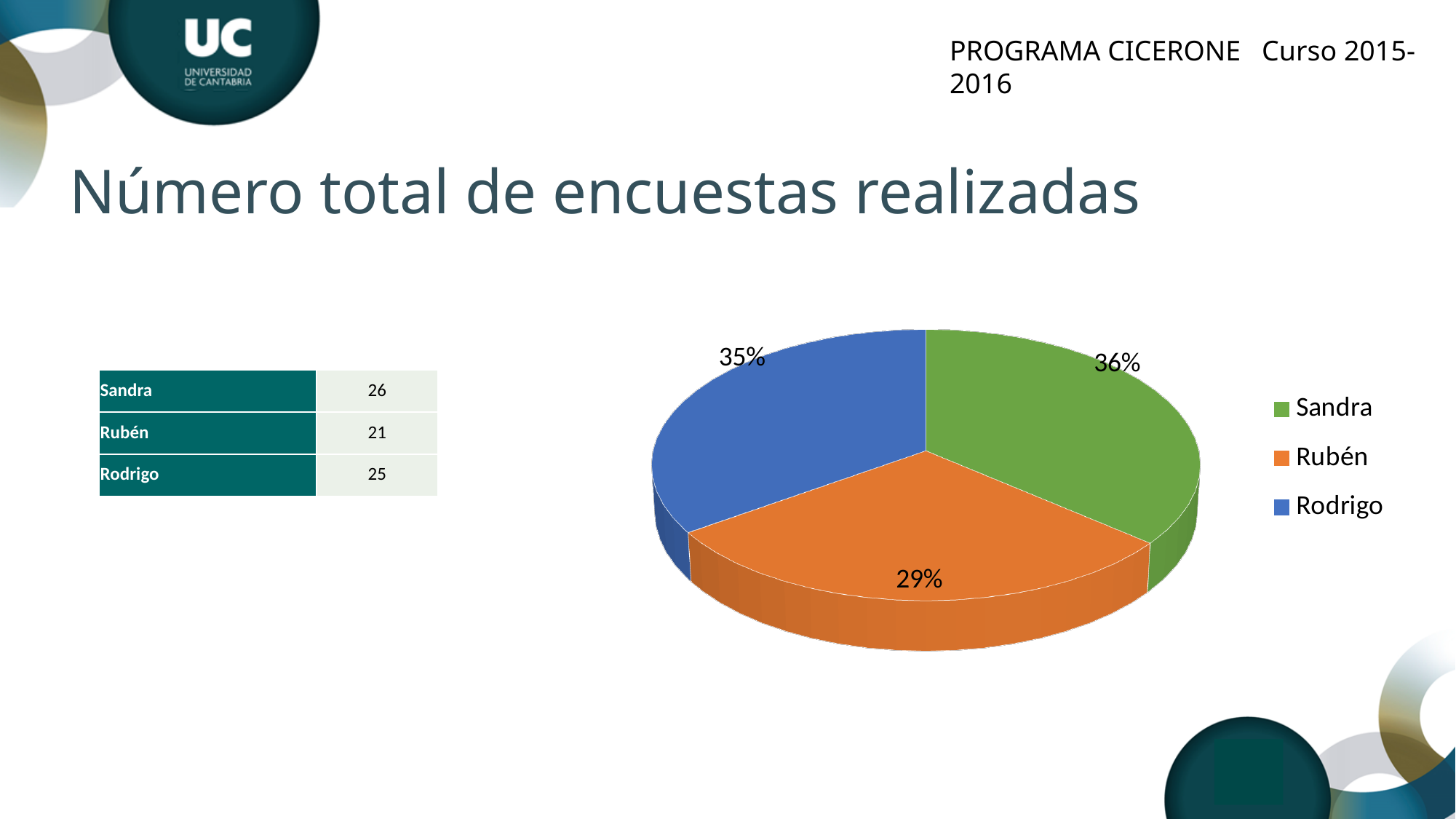
Which person has the smallest slice of the pie chart? Rubén What share of the pie does Rubén's slice represent? 29% What type of chart is shown on the slide? pie chart Which slice is larger, Rodrigo's or Rubén's? Rodrigo What share of the pie does Rodrigo's slice represent? 35% Which person has the largest slice of the pie chart? Sandra What is the difference in percentage points between Sandra's and Rubén's slices? 7 How many entries does the legend of the pie chart list? 3 What is the title of the slide containing the pie chart? Número total de encuestas realizadas What colour is Rodrigo's slice in the pie chart? blue How many slices does the pie chart have? 3 What share of the pie does Sandra's slice represent? 36%